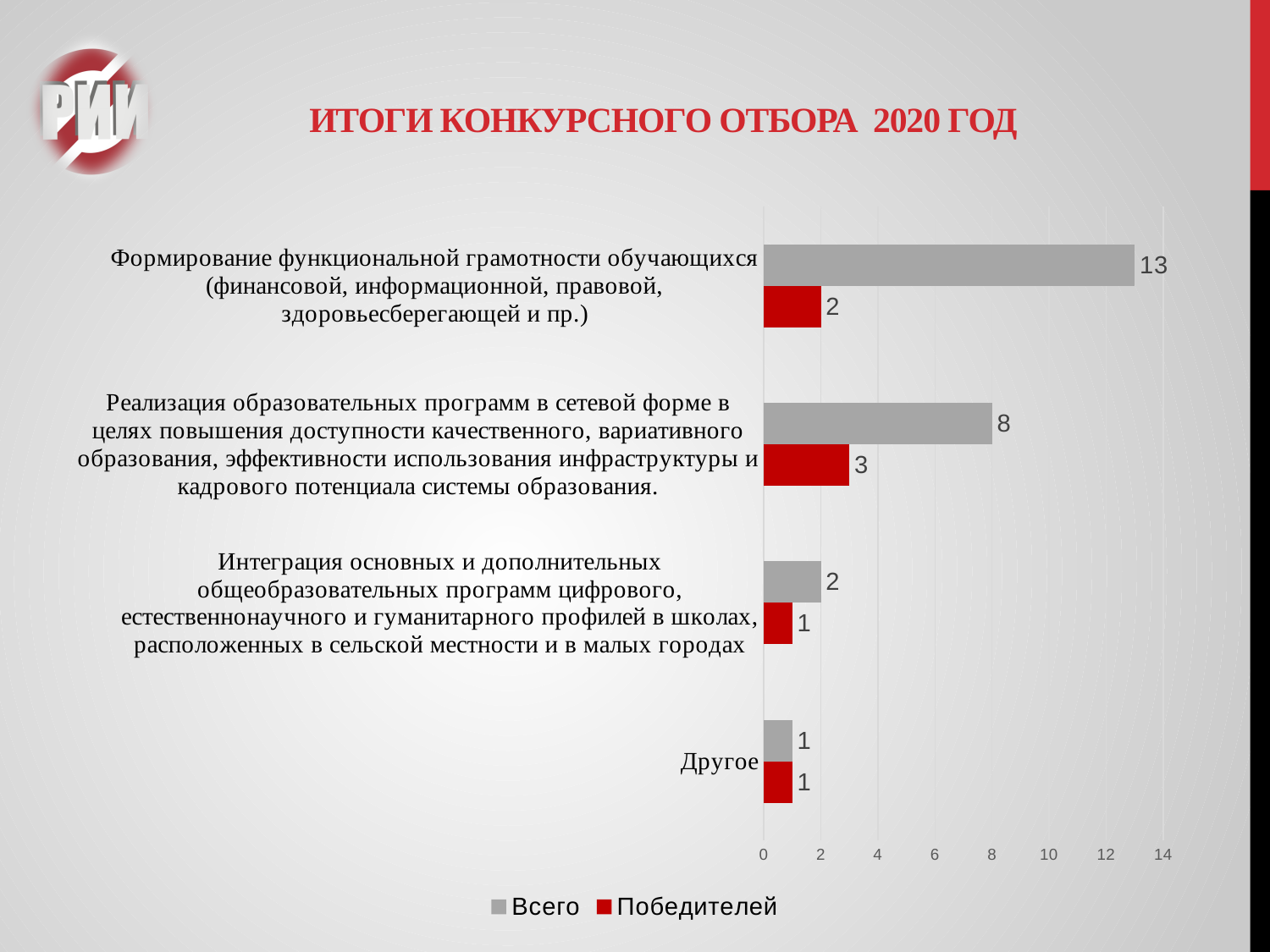
What type of chart is shown on the slide? Bar chart What colour are the 'Победителей' bars? Red Which is larger: the 'Всего' value for 'Реализация образовательных программ в сетевой форме' or the 'Всего' value for 'Интеграция основных и дополнительных общеобразовательных программ'? Реализация образовательных программ в сетевой форме Which category has the highest 'Победителей' value? Реализация образовательных программ в сетевой форме What is the difference between the 'Всего' and 'Победителей' values for 'Формирование функциональной грамотности обучающихся'? 11 What is the 'Всего' value for 'Другое'? 1 How many categories are shown on the chart? 4 Which category has the highest 'Всего' value? Формирование функциональной грамотности обучающихся What is the 'Победителей' value for 'Реализация образовательных программ в сетевой форме'? 3 What is the 'Всего' value for 'Формирование функциональной грамотности обучающихся'? 13 How many series does the legend list? 2 Is the 'Всего' value for 'Формирование функциональной грамотности обучающихся' greater or less than 10? greater